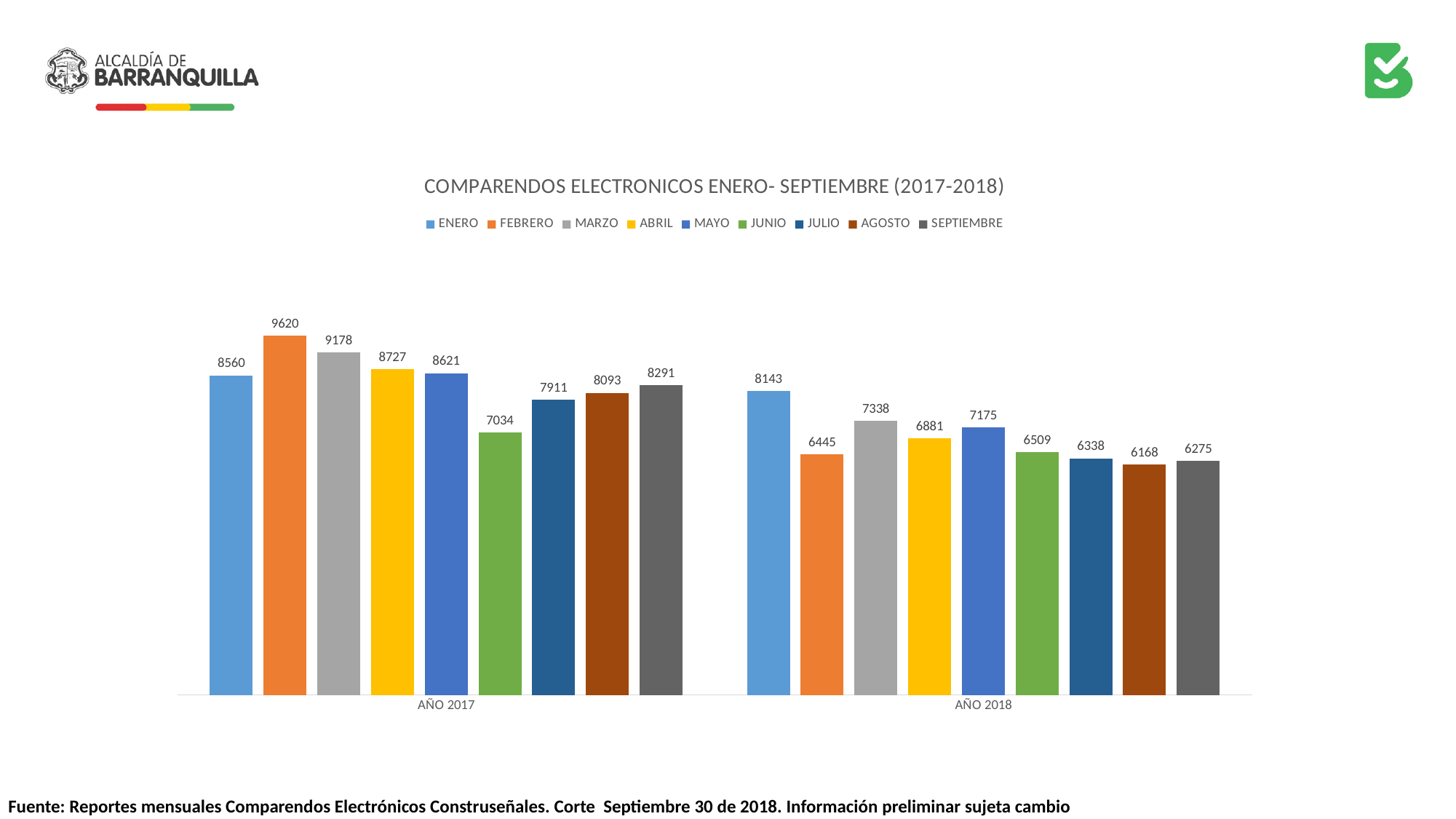
How many categories are shown on the x axis? 2 Which is larger, MARZO in AÑO 2018 or MAYO in AÑO 2018? MARZO in AÑO 2018 What kind of chart is shown on the slide? Bar chart Which month has the highest value in AÑO 2018? ENERO Which month has the lowest value in AÑO 2018? AGOSTO What is the value for JUNIO in AÑO 2017? 7034 What is the difference between the FEBRERO values for AÑO 2017 and AÑO 2018? 3175 Which month has the highest value in AÑO 2017? FEBRERO What is the value for FEBRERO in AÑO 2017? 9620 What is the difference between the ENERO values for AÑO 2017 and AÑO 2018? 417 How many series does the legend list? 9 What is the value for SEPTIEMBRE in AÑO 2018? 6275